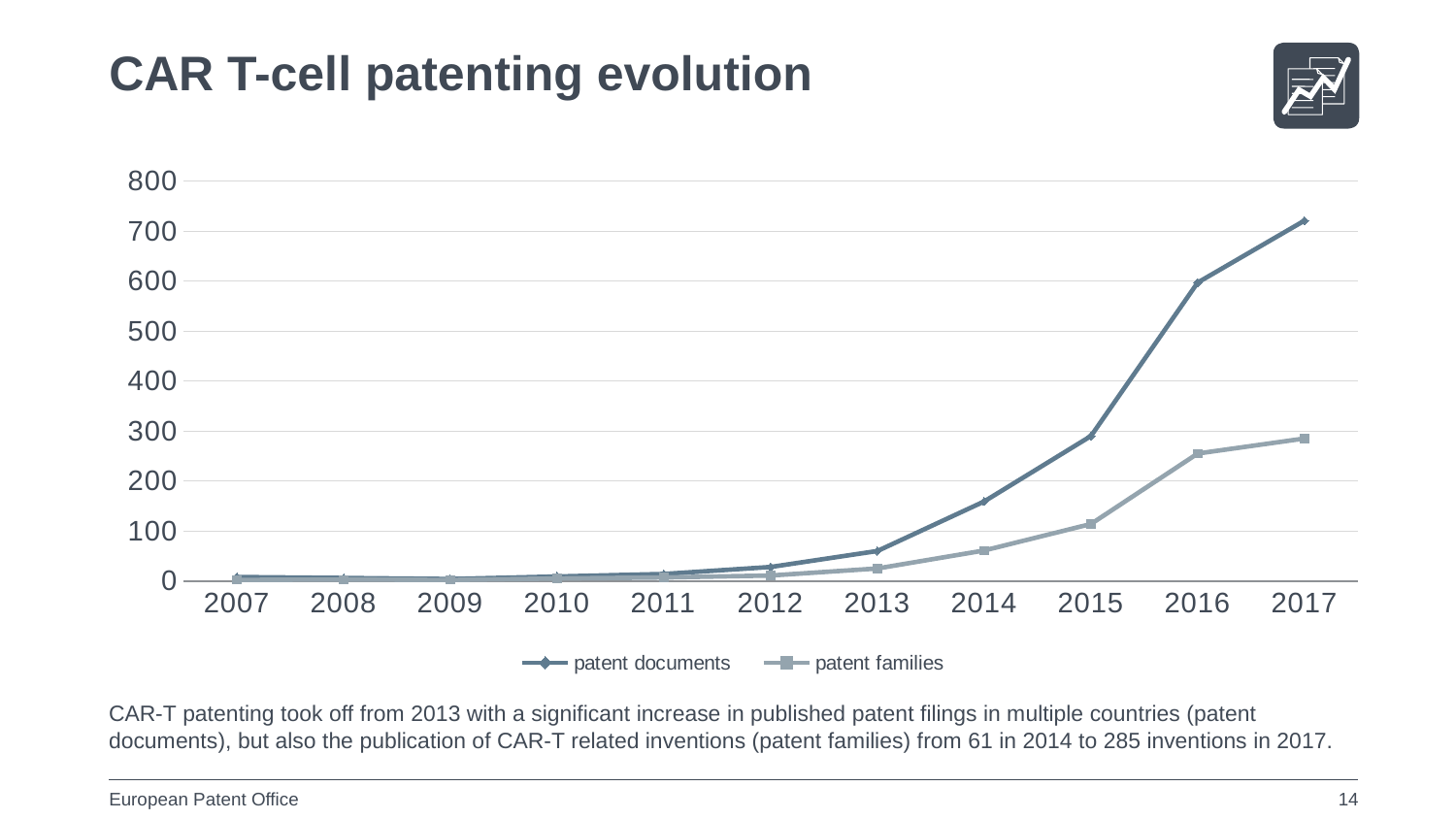
Is the value for patent families in 2015 greater or less than 200? less How many years are plotted along the x axis? 11 Is the value for patent documents in 2015 greater or less than 200? greater According to the slide, how many patent families were there in 2014? 61 Do the values for patent documents rise or fall from 2013 to 2017? rise Is the value for patent documents in 2017 greater or less than 700? greater In 2017, which series has the larger value, patent documents or patent families? patent documents What kind of chart is shown on the slide? line chart According to the slide, how many patent families were there in 2017? 285 How many series does the legend list? 2 In which year does the patent documents series reach its highest value? 2017